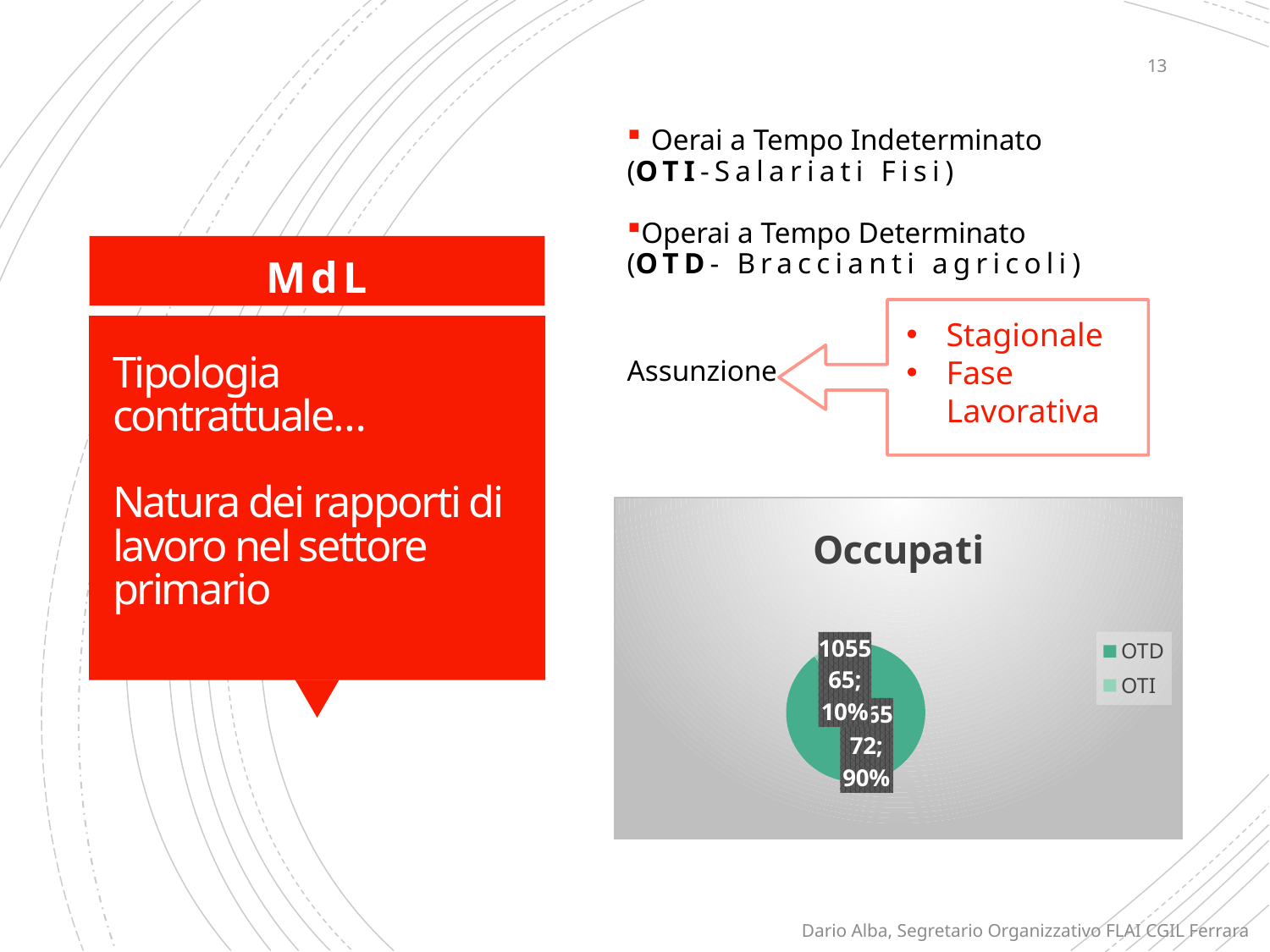
How many entries does the chart's legend list? 2 How many slices does the pie chart have? 2 What is the title of the chart on the slide? Occupati What kind of chart is shown on the slide? pie chart What share of the pie chart does OTD represent? 90% Which two categories are listed in the chart's legend? OTD and OTI What percentage share is shown for the smallest slice of the pie chart? 10% What percentage share is shown for the largest slice of the pie chart? 90% Which category takes up the larger share of the pie chart, OTD or OTI? OTD Which category has the smallest share in the pie chart? OTI